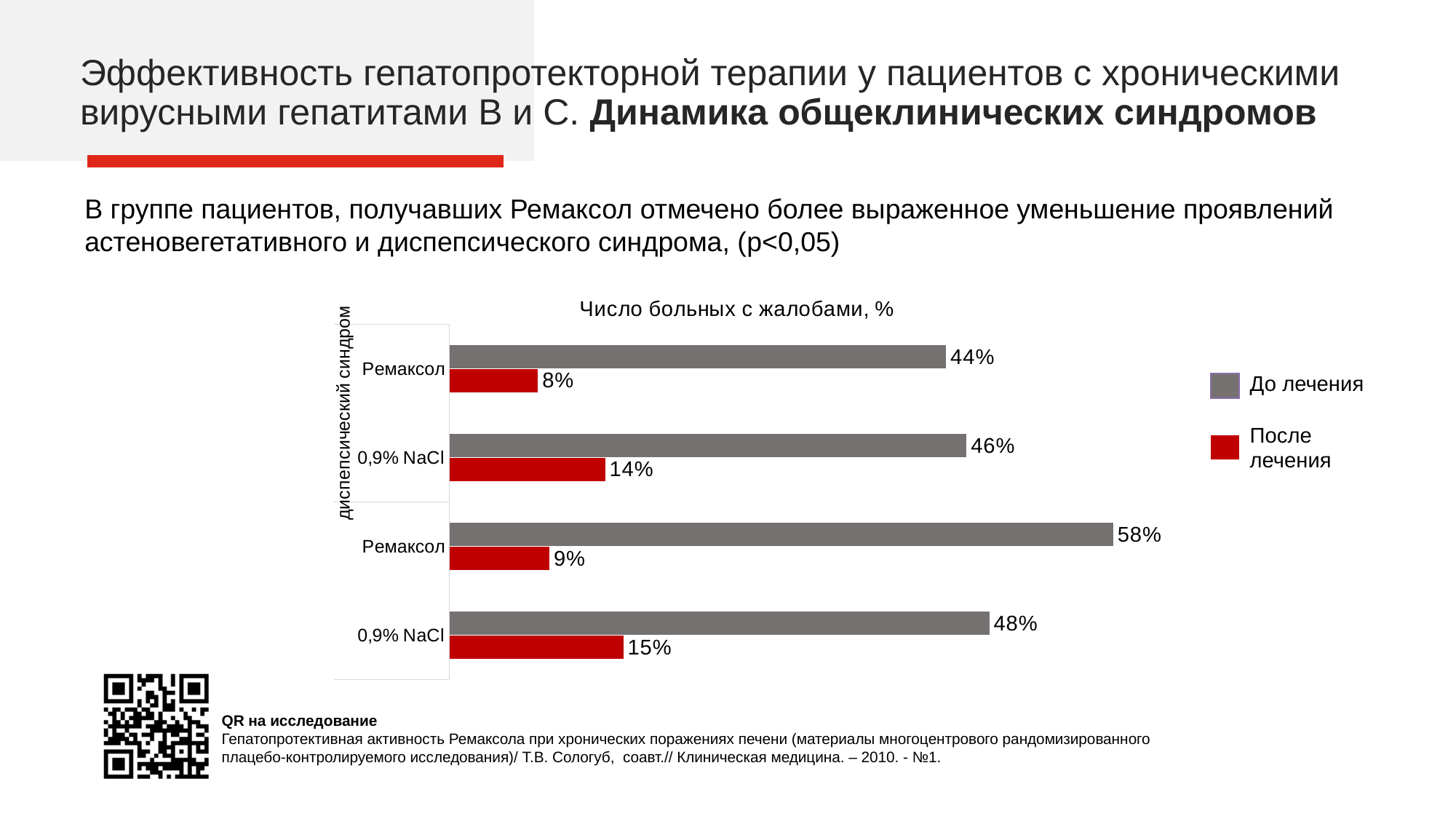
In the lower group of bars, what is the value for Ремаксол before treatment (До лечения)? 58% In the диспепсический синдром group, what is the value for Ремаксол after treatment (После лечения)? 8% In the диспепсический синдром group, what is the value for 0,9% NaCl after treatment (После лечения)? 14% Which series is shown in red in the chart? После лечения In the lower group of bars, which is larger after treatment: Ремаксол or 0,9% NaCl? 0,9% NaCl What type of chart is shown on the slide? bar chart In the диспепсический синдром group, what is the difference between the before-treatment and after-treatment values for Ремаксол? 36% Which bar has the highest value in the chart? Ремаксол, До лечения (lower group), 58% In the диспепсический синдром group, what is the value for Ремаксол before treatment (До лечения)? 44% In the lower group of bars, what is the value for 0,9% NaCl after treatment (После лечения)? 15% How many series does the chart legend list? 2 What is the title of the chart? Число больных с жалобами, %